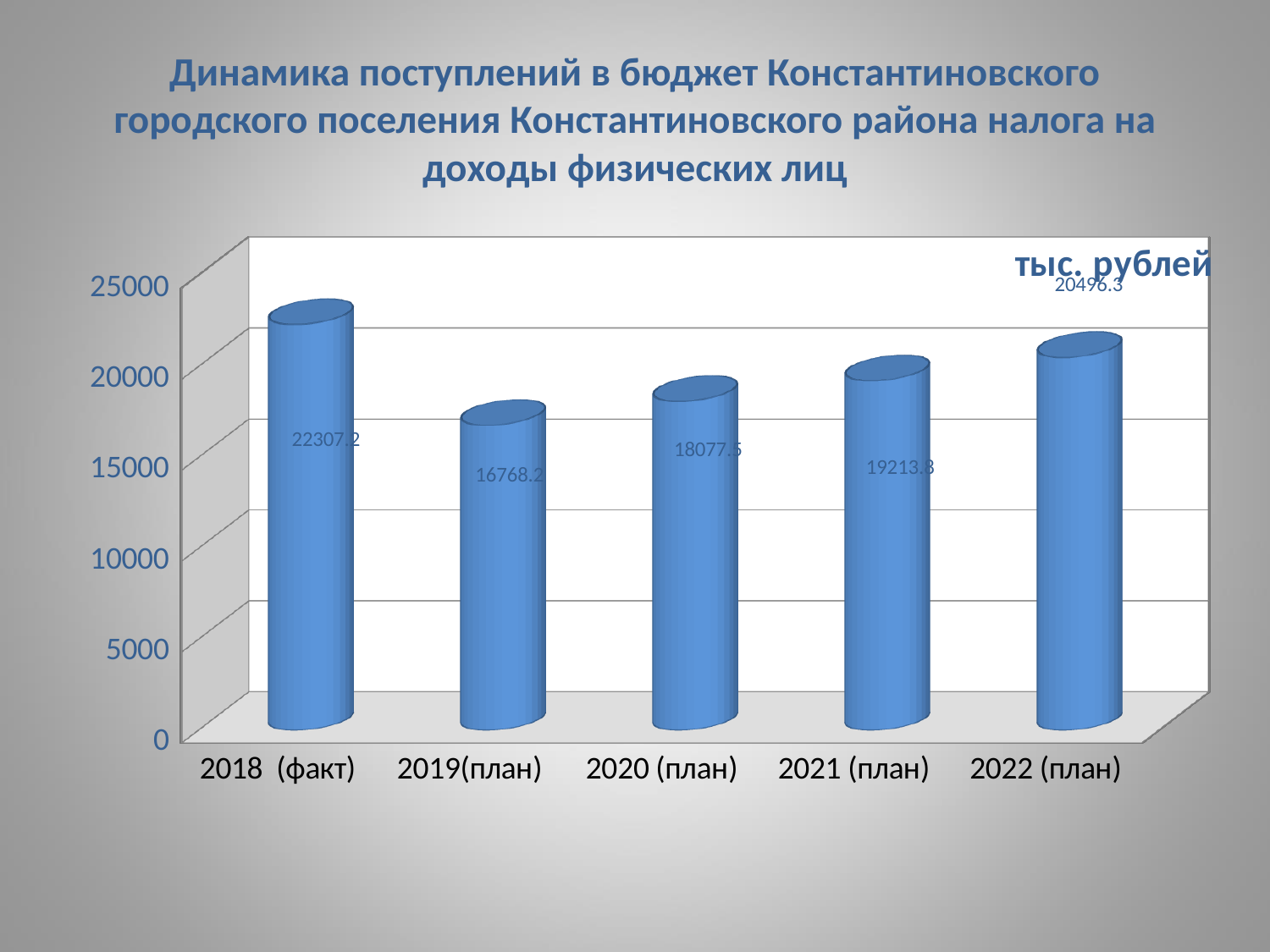
Do the values rise or fall from 2019(план) to 2022 (план)? rise What is the difference between the values for 2018 (факт) and 2019(план)? 5539.0 How many years are shown on the x axis? 5 Is the value for 2020 (план) greater or less than 20000? less What is the value for 2022 (план)? 20496.3 What is the value for 2018 (факт)? 22307.2 Which is larger, the value for 2020 (план) or 2021 (план)? 2021 (план) What is the difference between the values for 2022 (план) and 2019(план)? 3728.1 Which year has the lowest value? 2019(план) What kind of chart is shown on the slide? bar chart What is the value for 2019(план)? 16768.2 Which year has the highest value? 2018 (факт)